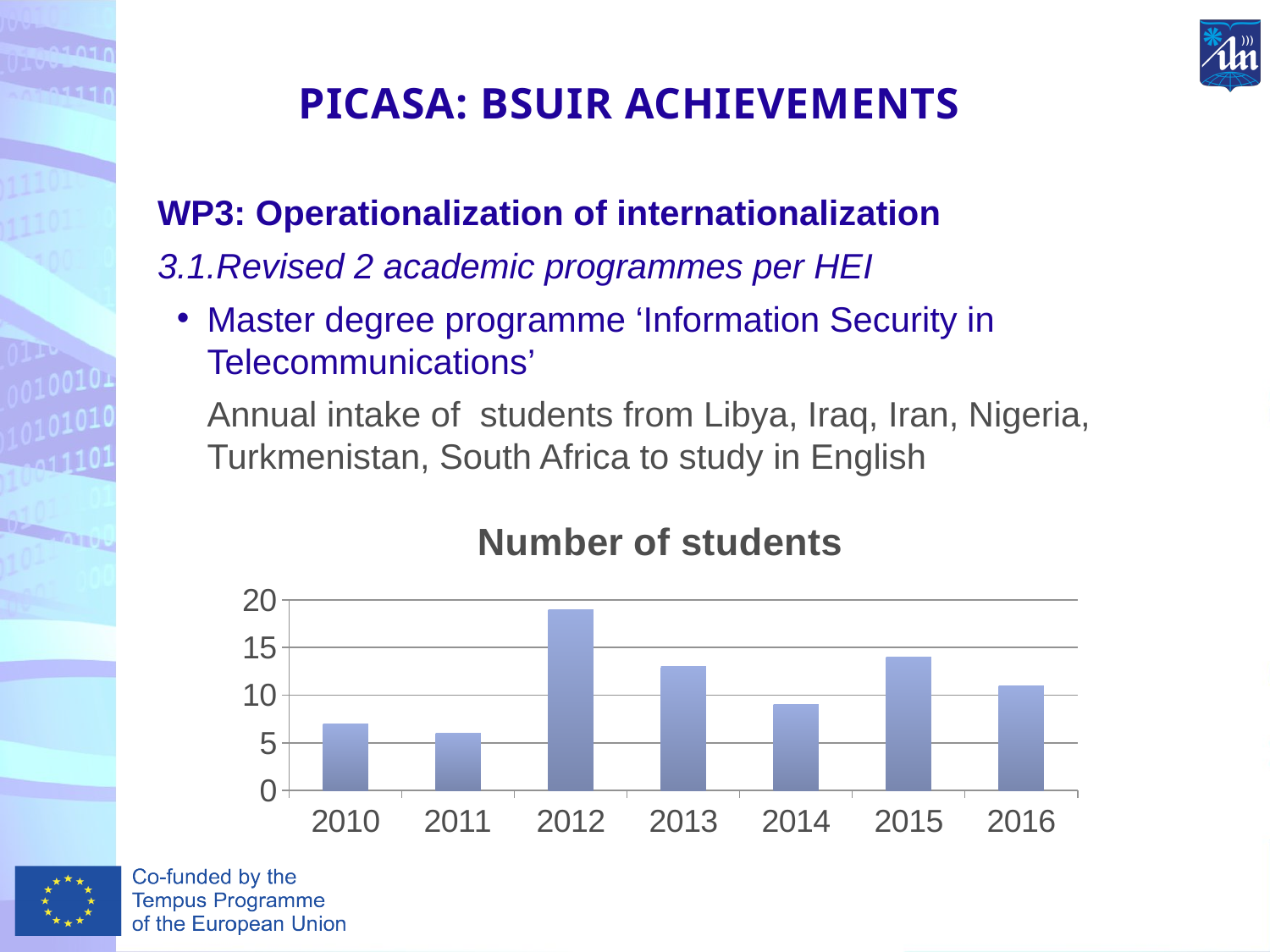
Which year has the highest number of students? 2012 What kind of chart is shown on the slide? bar chart Is the value for 2013 greater or less than 10? greater What is the title of the chart? Number of students Which is larger, the value for 2012 or the value for 2013? 2012 Which is larger, the value for 2014 or the value for 2015? 2015 Is the value for 2016 greater or less than 15? less Is the value for 2012 greater or less than 15? greater Do the values rise or fall from 2012 to 2014? fall How many years are shown on the x axis of the chart? 7